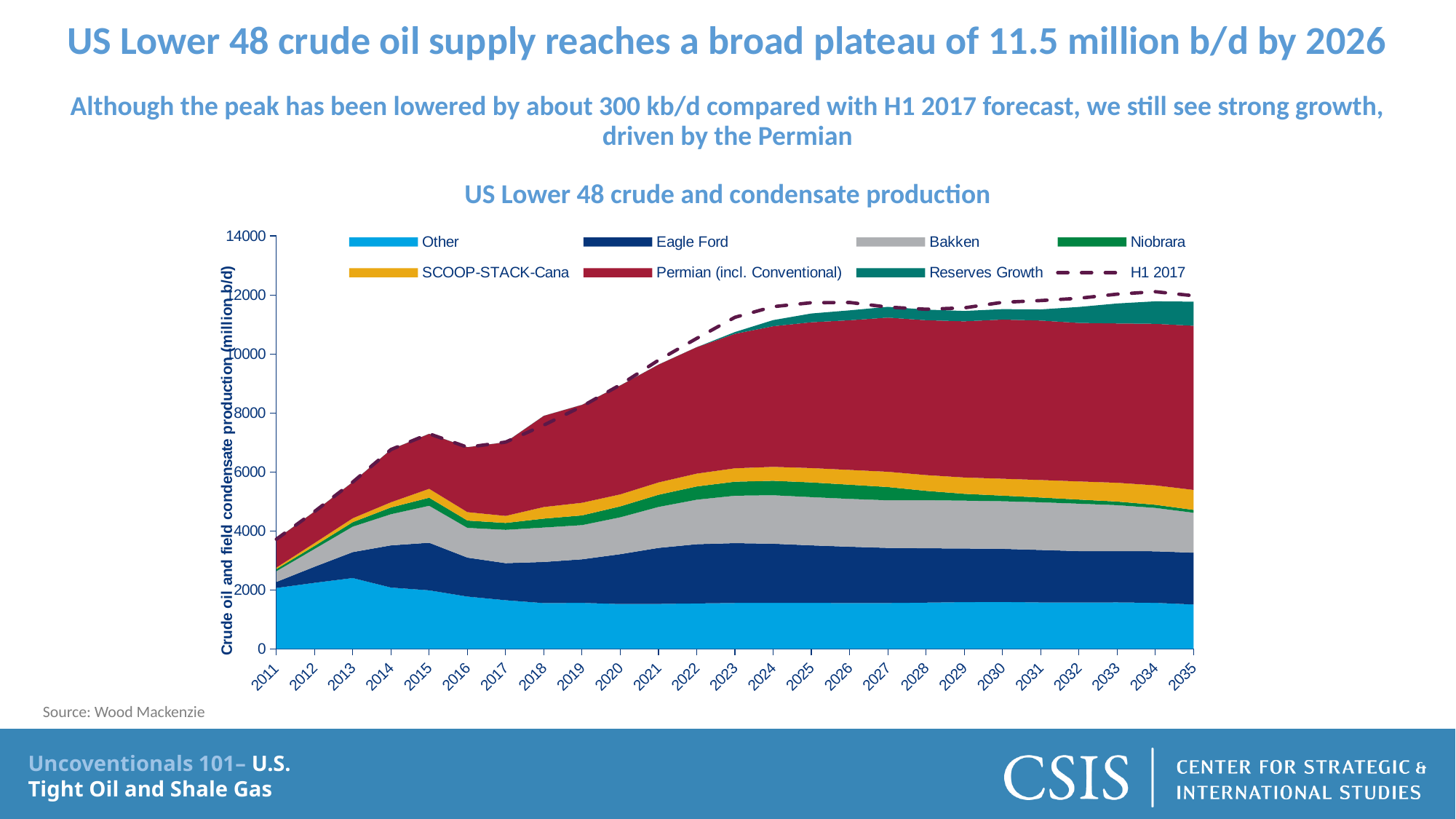
Which series has the largest band in 2035? Permian (incl. Conventional) How many series does the chart legend list? 8 Is the total stacked production in 2015 greater or less than 6000? greater Is the value of the H1 2017 line in 2025 greater or less than 10000? greater Is the total stacked production in 2011 greater or less than 4000? less Does the total stacked production rise or fall between 2011 and 2015? rise How many years are shown along the x axis of the chart? 25 Which series is drawn as a dashed line rather than a filled area? H1 2017 Does the total stacked production rise or fall between 2015 and 2016? fall What kind of chart is shown on the slide? Stacked area chart What is the title of the chart? US Lower 48 crude and condensate production